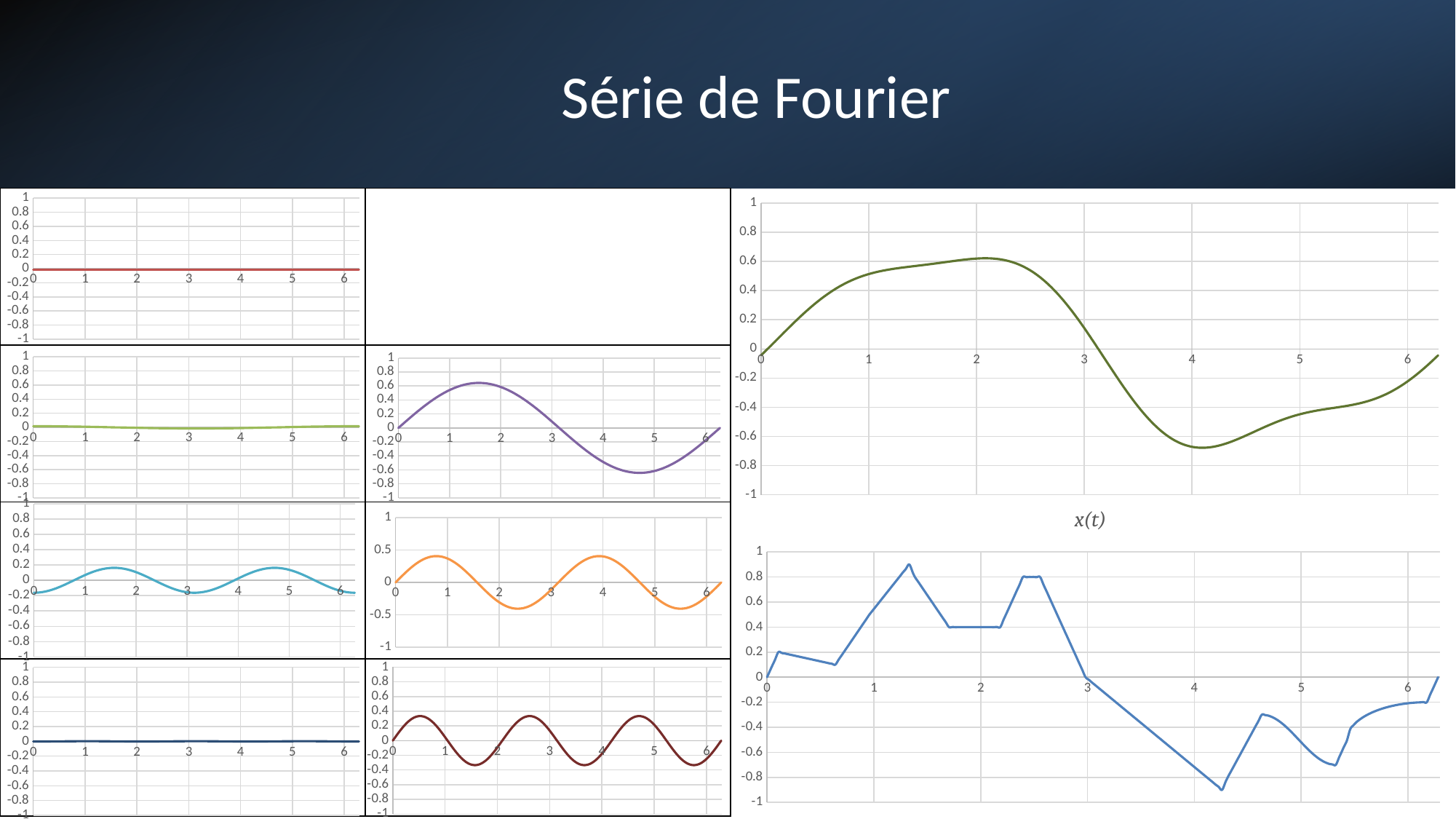
In the top-right chart, is the maximum value (near x=2) greater or less than 0.4? greater In the top-right chart, does the line rise or fall between x=0 and x=2? rise In the orange chart in the middle column, is the peak value greater or less than 0.5? less In the bottom-right chart x(t), is the peak value reached between x=1 and x=2 greater or less than 0.8? greater What kind of chart is the bottom-right chart titled x(t)? line chart How many small charts are stacked in the left-hand column of the slide? 4 In the top-right chart, which is larger: the value at x=1 or the value at x=3? the value at x=1 In the bottom-right chart x(t), does the line rise or fall between x=3 and x=4? fall What is the title of the bottom-right chart? x(t)